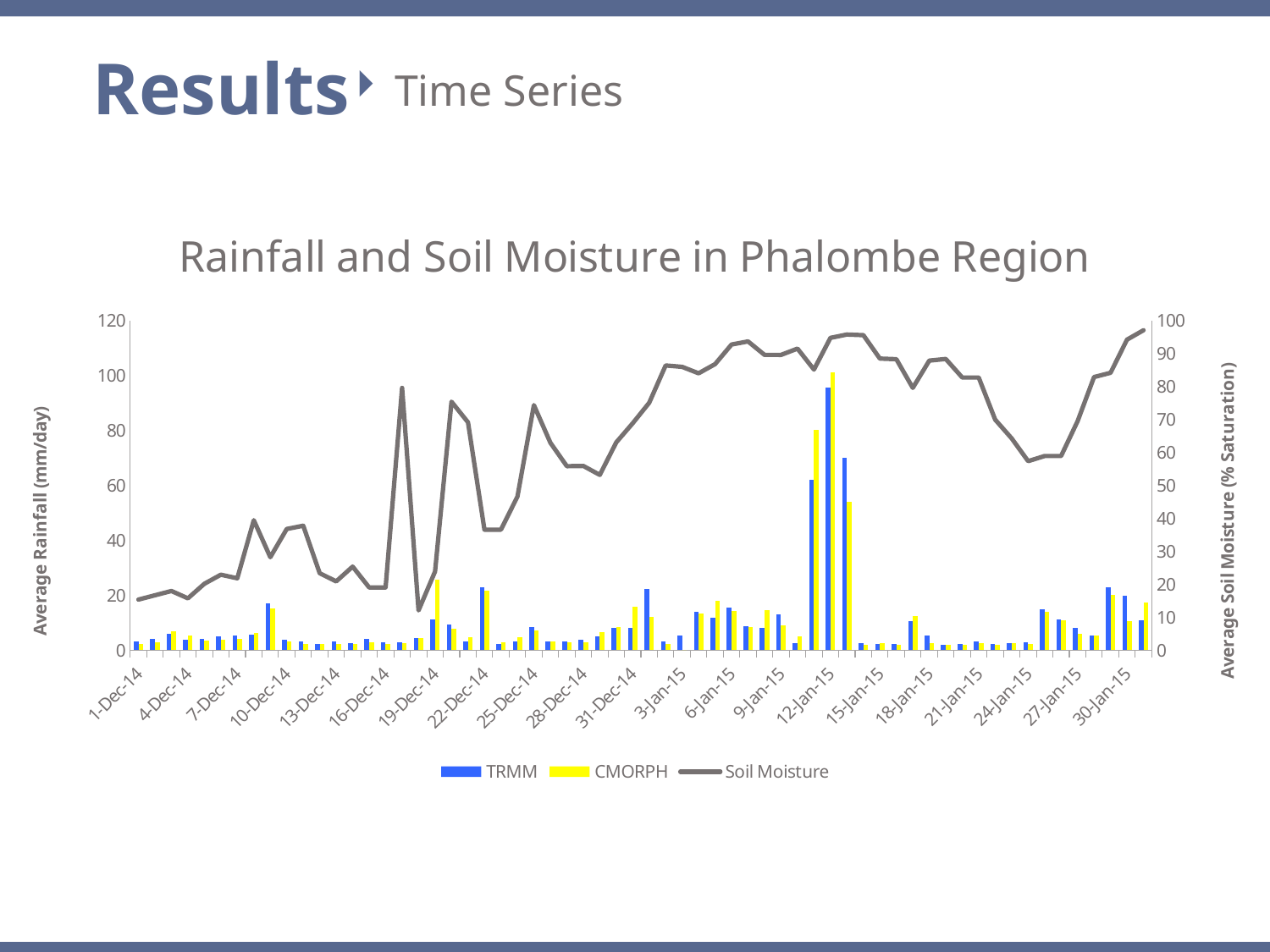
Is the highest TRMM rainfall value greater or less than 80? greater How many series does the legend list? 3 Which is larger, the Soil Moisture value on 1-Dec-14 or on 30-Jan-15? 30-Jan-15 Is the highest CMORPH rainfall value greater or less than 80? greater Overall, does the Soil Moisture line rise or fall from 1-Dec-14 to 30-Jan-15? rise Is the Soil Moisture value on 1-Dec-14 greater or less than 20? less What kind of chart is shown on the slide? A combined bar and line chart What is the title of the chart? Rainfall and Soil Moisture in Phalombe Region How many date labels are shown on the x axis? 21 Which series is plotted as a line rather than bars? Soil Moisture